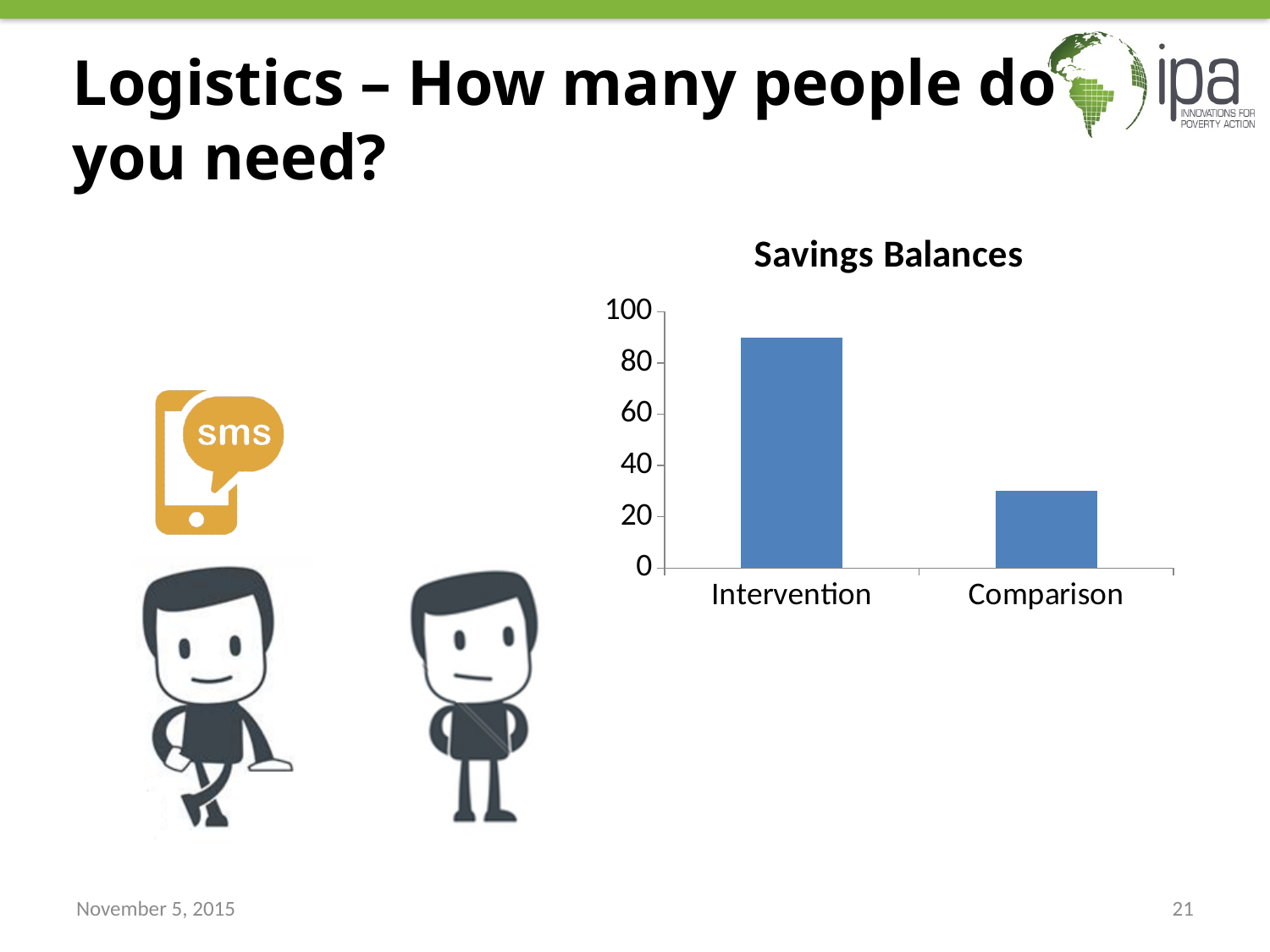
Which category has the highest value in the Savings Balances chart? Intervention What is the title of the chart on the slide? Savings Balances Is the value for Intervention greater or less than 100? less Is the value for Intervention greater or less than 80? greater Do the values rise or fall from Intervention to Comparison in the Savings Balances chart? fall Which category has the lowest value in the Savings Balances chart? Comparison What type of chart is shown under the title "Savings Balances"? bar chart How many categories are shown on the x axis of the Savings Balances chart? 2 Is the value for Comparison greater or less than 40? less In the Savings Balances chart, which is larger, Intervention or Comparison? Intervention What is the highest value labelled on the y axis of the Savings Balances chart? 100